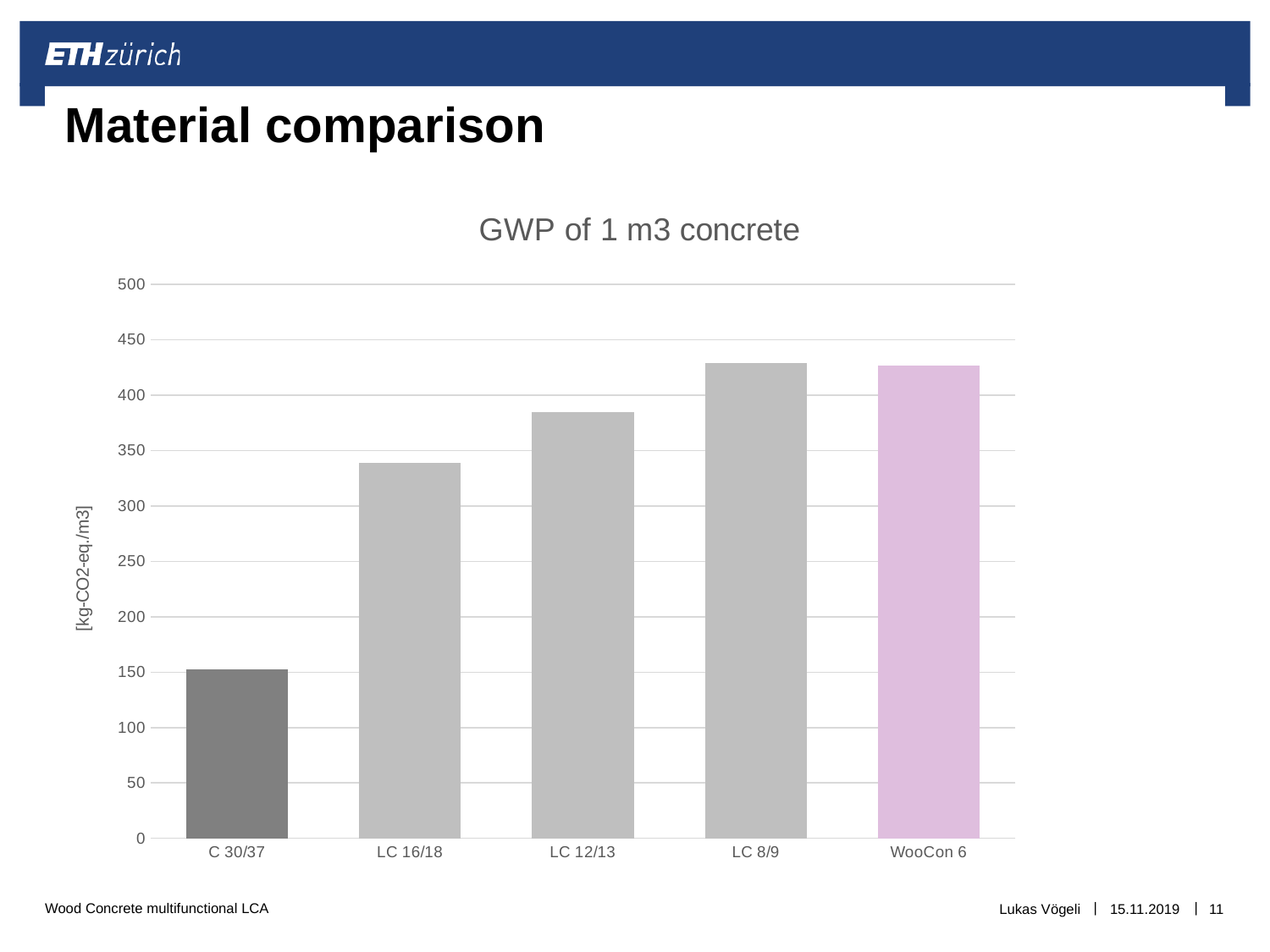
What is the label on the y axis of the chart? [kg-CO2-eq./m3] Which has a larger GWP value, LC 12/13 or WooCon 6? WooCon 6 How many categories are shown on the x axis of the chart? 5 Is the value for LC 12/13 greater or less than 400? less Is the value for C 30/37 greater or less than 200? less Which category has the lowest GWP value in the chart? C 30/37 Is the value for LC 16/18 greater or less than 300? greater What is the title of the chart? GWP of 1 m3 concrete Which has a larger GWP value, C 30/37 or LC 16/18? LC 16/18 What kind of chart is shown on the slide? bar chart